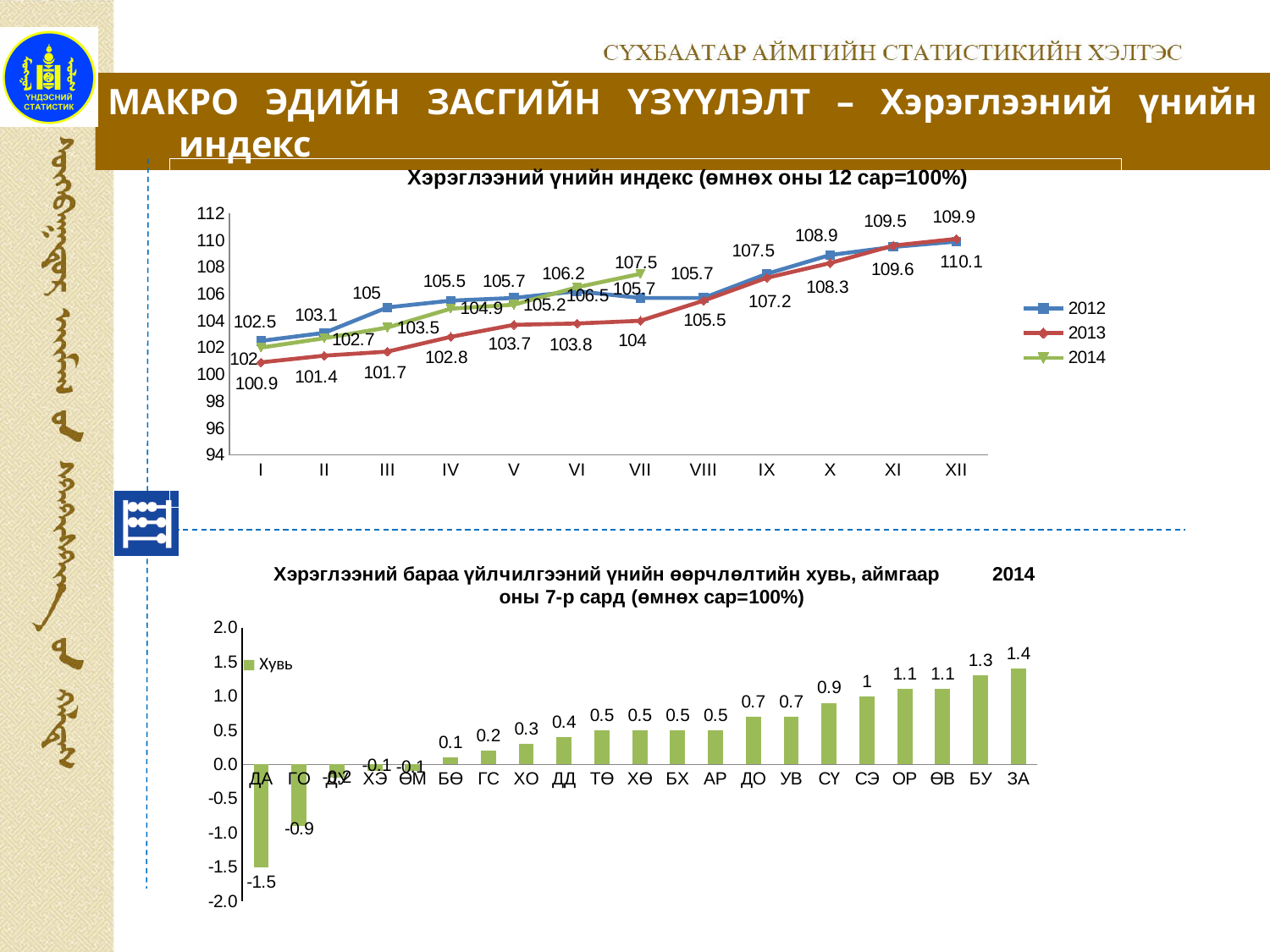
In the bottom bar chart, what is the difference between the values for ЗА and ДА? 2.9 In the top chart 'Хэрэглээний үнийн индекс', how many series does the legend list? 3 In the top chart 'Хэрэглээний үнийн индекс', what is the value of the 2014 series at month VII? 107.5 In the top chart 'Хэрэглээний үнийн индекс', which years are listed in the legend? 2012, 2013, 2014 What kind of chart is the bottom chart, 'Хэрэглээний бараа үйлчилгээний үнийн өөрчлөлтийн хувь, аймгаар'? Bar chart In the bottom bar chart, how many aimags (categories) are shown on the x axis? 21 In the bottom bar chart, which aimag has the lowest value? ДА In the bottom bar chart, which aimag has the highest value? ЗА In the top chart 'Хэрэглээний үнийн индекс', does the 2013 series rise or fall from month I to month XII? Rise What kind of chart is the top chart, 'Хэрэглээний үнийн индекс (өмнөх оны 12 сар=100%)'? Line chart In the bottom bar chart, what is the value for СҮ? 0.9 In the top chart 'Хэрэглээний үнийн индекс', what is the value of the 2013 series at month XII? 110.1